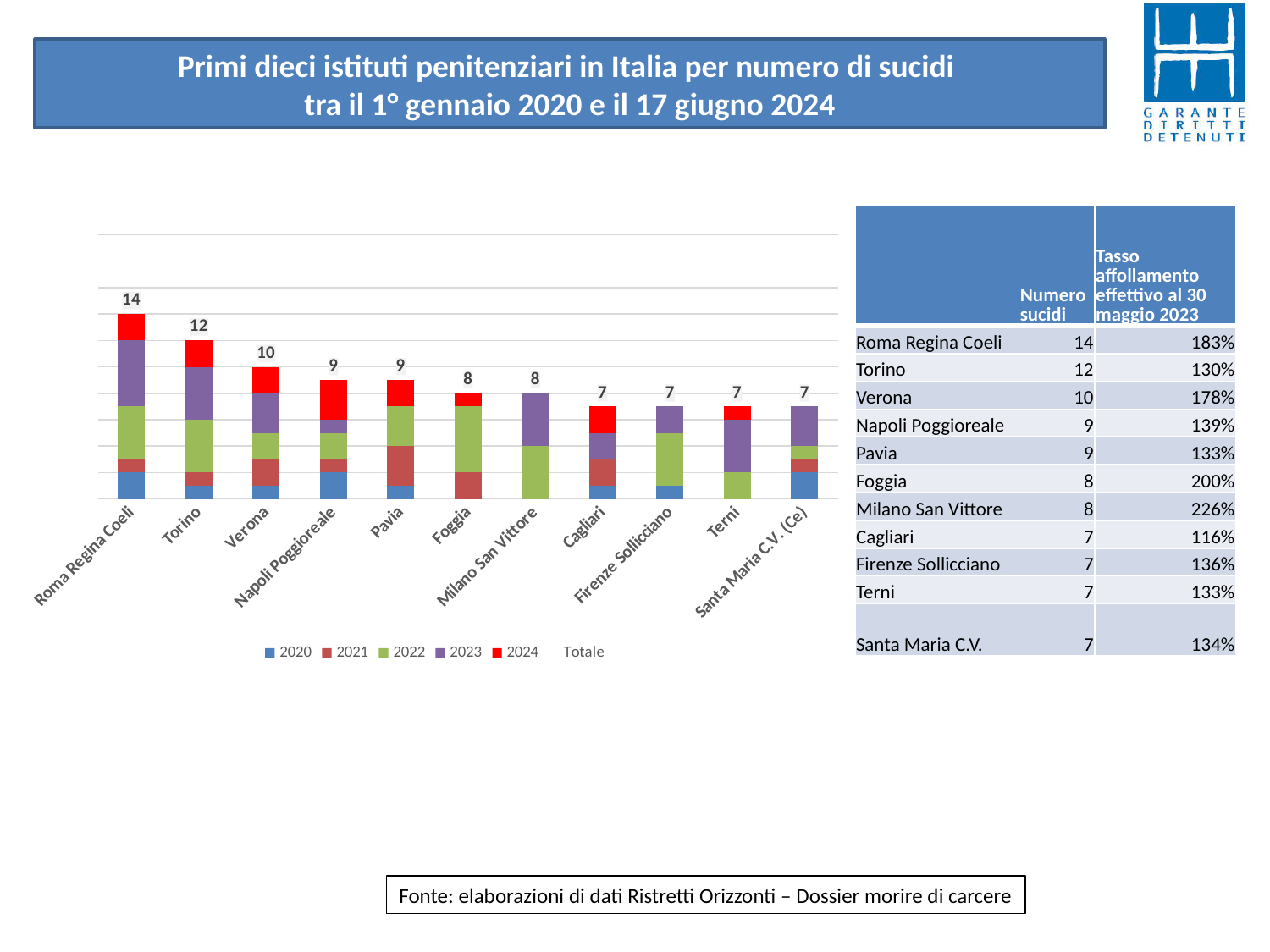
How many entries does the chart legend list? 6 What is the total of the stacked bar for Foggia? 8 What is the total value labelled above the bar for Verona? 10 Which has a larger total, Verona or Pavia? Verona What is the difference between the totals for Roma Regina Coeli and Torino? 2 How many institutes (categories) are plotted on the x axis of the chart? 11 Which colour represents the year 2024 in the chart legend? Red What is the lowest total value shown in the chart? 7 What is the total number of suicides shown for Roma Regina Coeli? 14 Which institute has the highest total in the chart? Roma Regina Coeli What kind of chart is shown on the slide? Stacked bar chart Do the total values rise or fall moving from left to right along the x axis? Fall